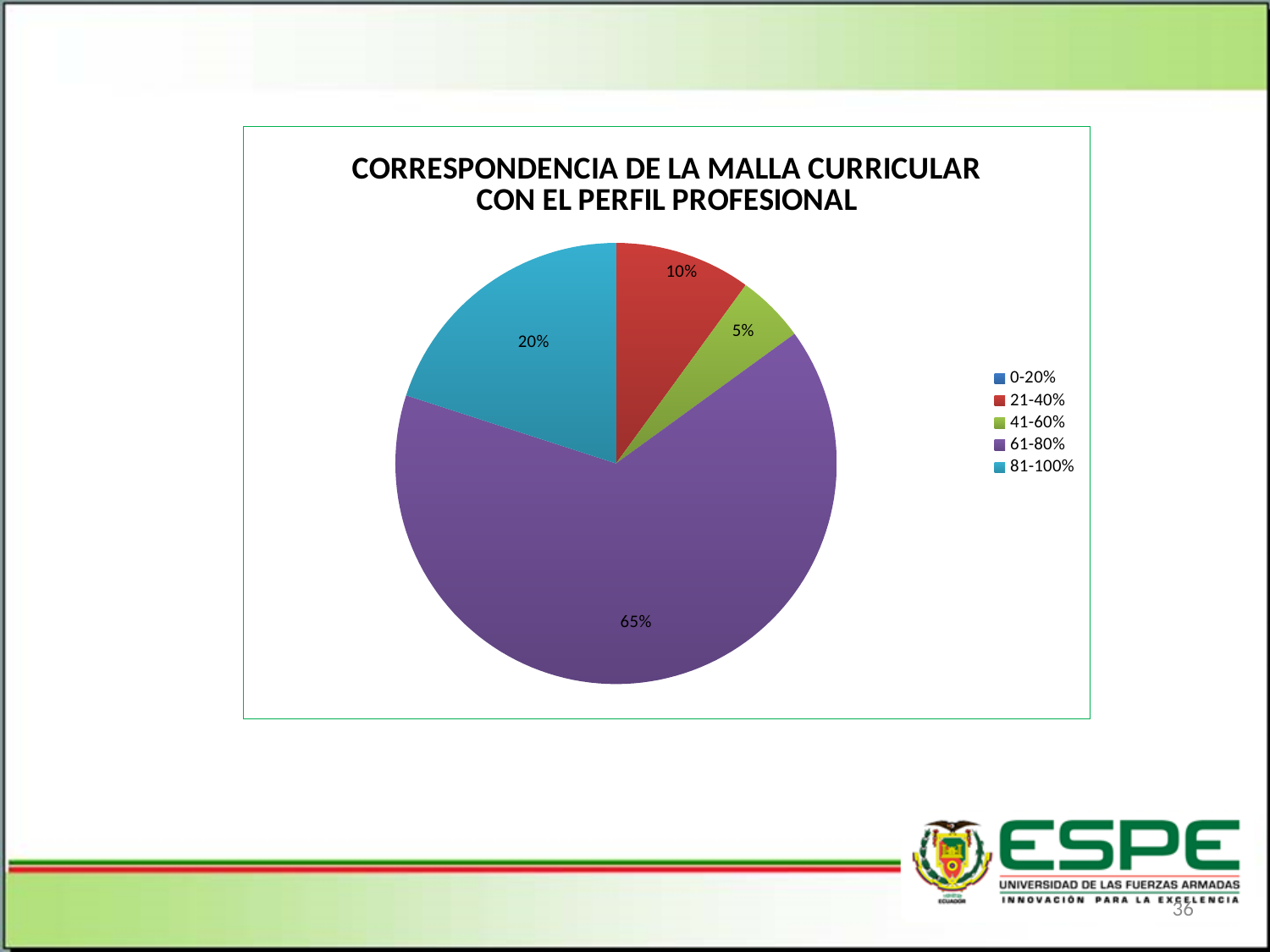
What share of the pie does the 41-60% category have? 5% What colour is the 61-80% slice? purple What share of the pie does the 61-80% category have? 65% What is the difference between the 61-80% share and the 81-100% share? 45% What type of chart is shown on the slide? pie chart How many categories does the legend list? 5 What is the title of the chart? CORRESPONDENCIA DE LA MALLA CURRICULAR CON EL PERFIL PROFESIONAL What share of the pie does the 81-100% category have? 20% Which labelled slice of the pie is the smallest? 41-60% Which is larger, the 21-40% slice or the 81-100% slice? 81-100% Which category has the largest slice of the pie? 61-80%